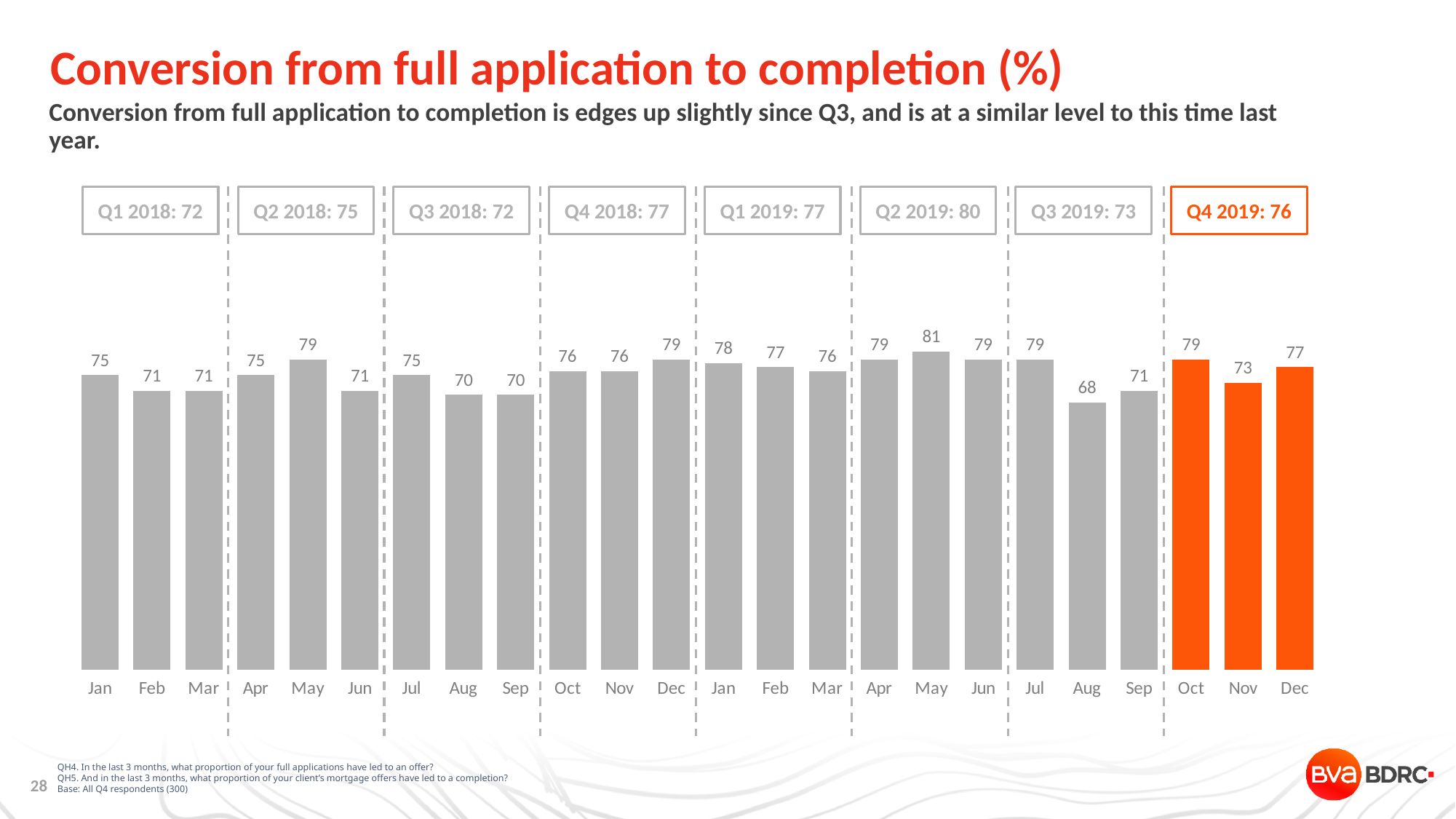
What is the quarterly value shown in the box for Q2 2019? 80 Which month has the lowest conversion value on the chart? Aug 2019 What is the difference between the quarterly values for Q3 2019 and Q4 2019? 3 How many monthly bars are plotted on the chart? 24 Which months' bars are coloured orange rather than grey? Oct, Nov and Dec 2019 What kind of chart is shown on the slide? Bar chart Which month has the highest conversion value on the chart? May 2019 What is the conversion value for May 2019? 81 Which is larger, the value for Jan 2018 or the value for Jan 2019? Jan 2019 What is the difference between the values for Oct 2019 and Nov 2019? 6 What is the conversion value for Dec 2019? 77 What is the conversion value for Aug 2019? 68